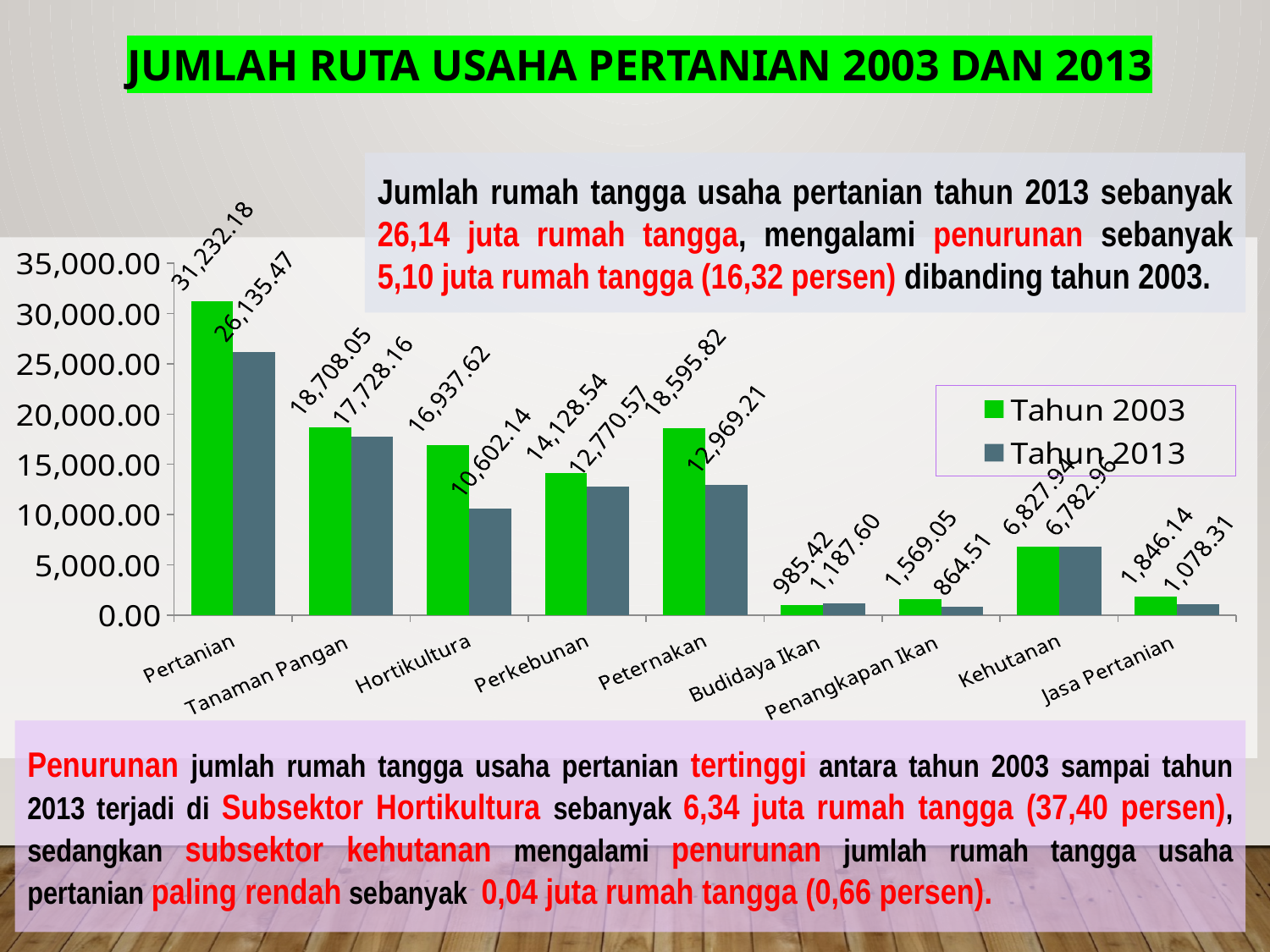
What kind of chart is shown on the slide? bar chart How many categories are shown on the x axis? 9 Which series is shown in green in the legend? Tahun 2003 How many series does the legend list? 2 What is the value for Peternakan in the Tahun 2003 series? 18,595.82 Which is larger for Budidaya Ikan: the Tahun 2003 value or the Tahun 2013 value? Tahun 2013 Which category has the lowest value in the Tahun 2003 series? Budidaya Ikan What is the difference between the Tahun 2003 and Tahun 2013 values for Hortikultura? 6,335.48 Which category has the highest value in the Tahun 2013 series? Pertanian What is the value for Jasa Pertanian in the Tahun 2013 series? 1,078.31 What is the value for Pertanian in the Tahun 2003 series? 31,232.18 What is the value for Hortikultura in the Tahun 2013 series? 10,602.14